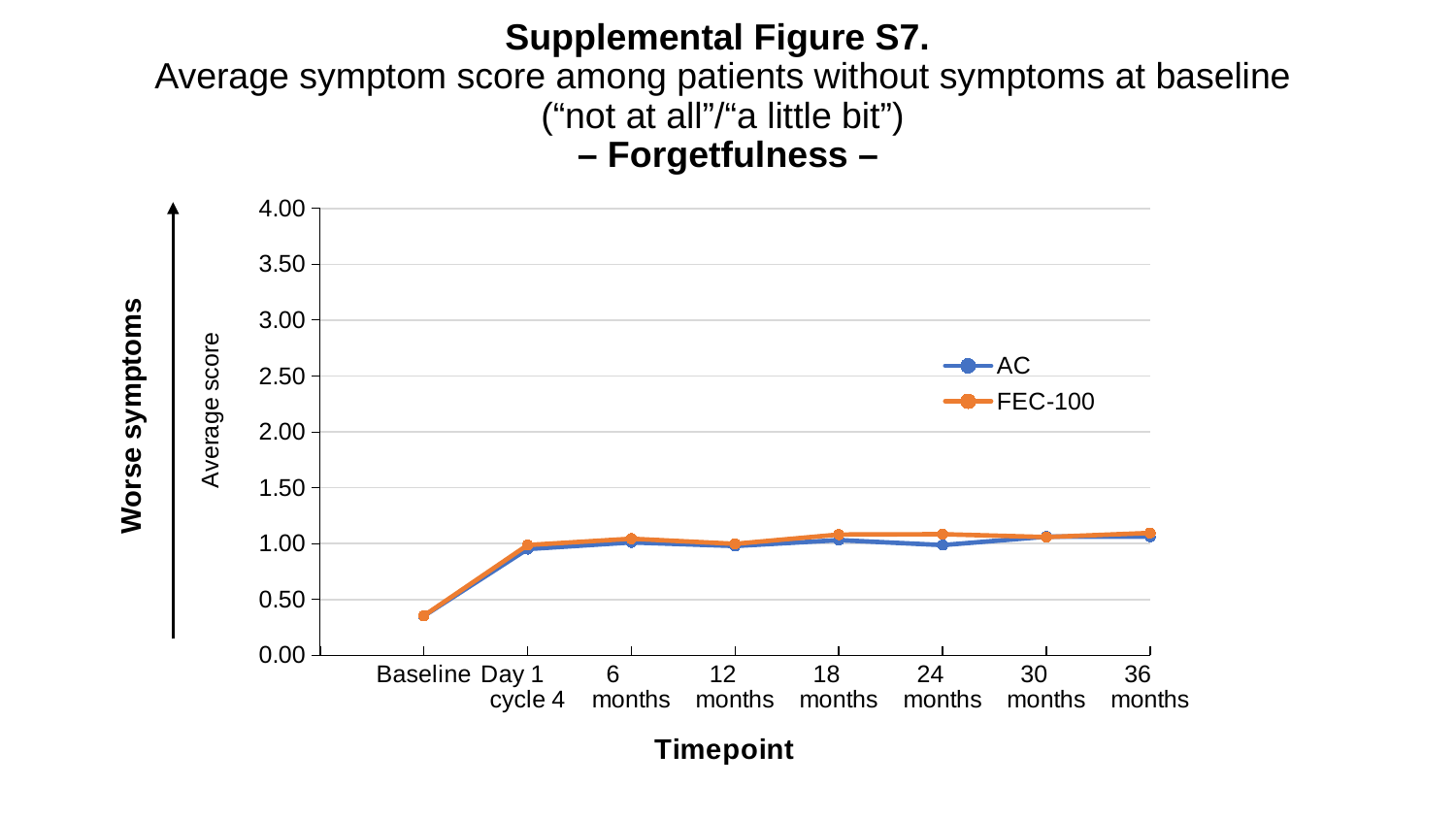
Which two series are listed in the legend? AC and FEC-100 How many series does the legend list? 2 How many timepoints are plotted along the x axis? 8 What is the label of the y axis? Average score At 24 months, which series has the higher value, AC or FEC-100? FEC-100 Is the value for AC at Baseline greater or less than 0.50? less Does the average score rise or fall from Baseline to Day 1 cycle 4? Rises Is the value for FEC-100 at 6 months greater or less than 1.50? less At which timepoint is the AC series at its lowest value? Baseline Is the value for FEC-100 at 36 months greater or less than 1.00? greater What kind of chart is shown on the slide? Line chart